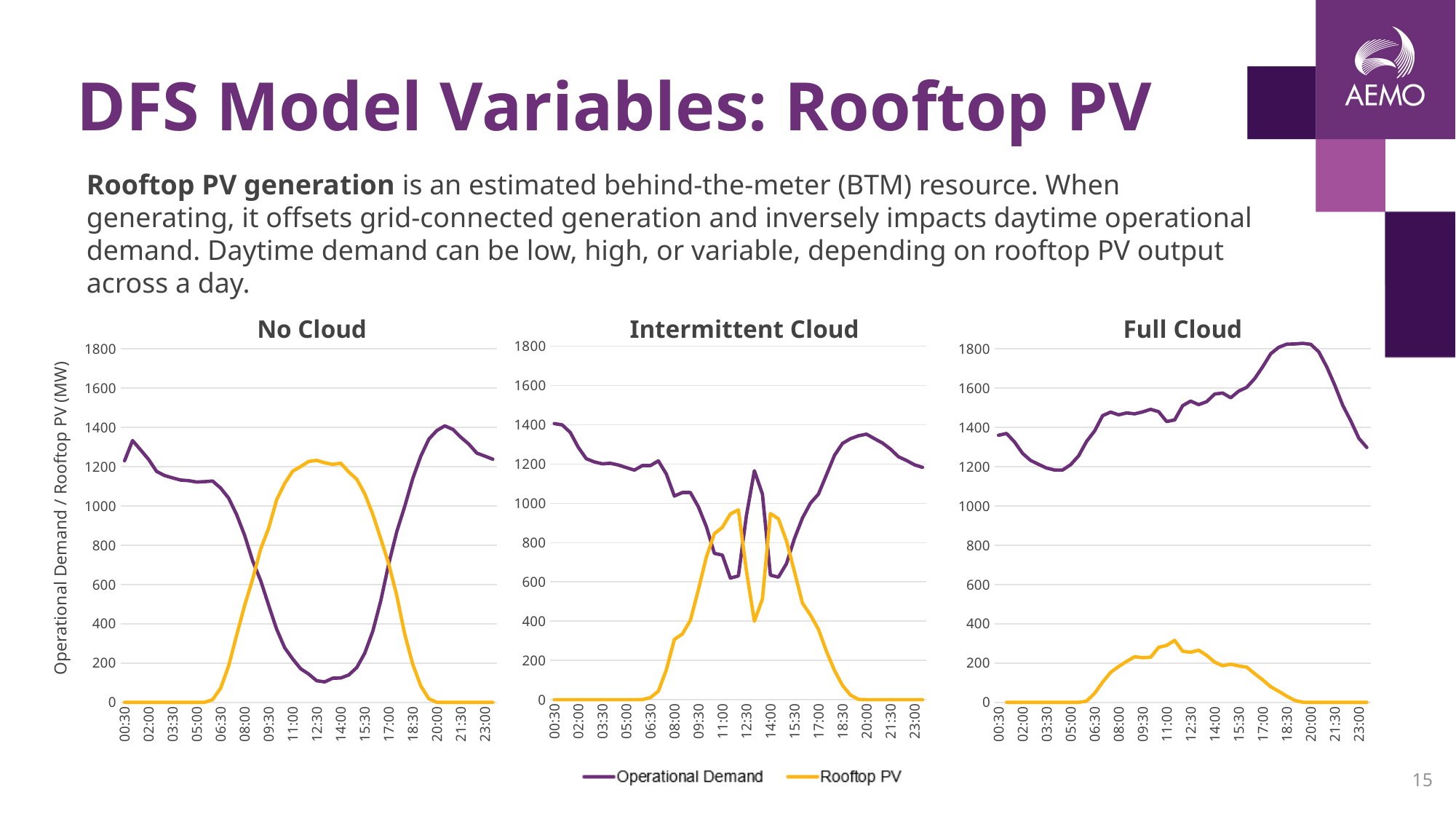
What are the titles of the three charts on the slide? No Cloud, Intermittent Cloud, Full Cloud In the 'Intermittent Cloud' chart, is the Operational Demand value at 00:30 greater or less than 1200? greater In the 'Full Cloud' chart, is the Operational Demand value at 20:00 greater or less than 1600? greater Which series is drawn in orange in the charts? Rooftop PV What kind of chart is the 'No Cloud' chart? Line chart How many time labels are shown on the x axis of the 'No Cloud' chart? 16 In the 'No Cloud' chart, is the Rooftop PV value at 12:30 greater or less than 1000? greater In the 'No Cloud' chart, which series is larger at 12:30, Operational Demand or Rooftop PV? Rooftop PV In the 'Full Cloud' chart, which series is larger at 12:30, Operational Demand or Rooftop PV? Operational Demand How many series does the legend list for the charts? 2